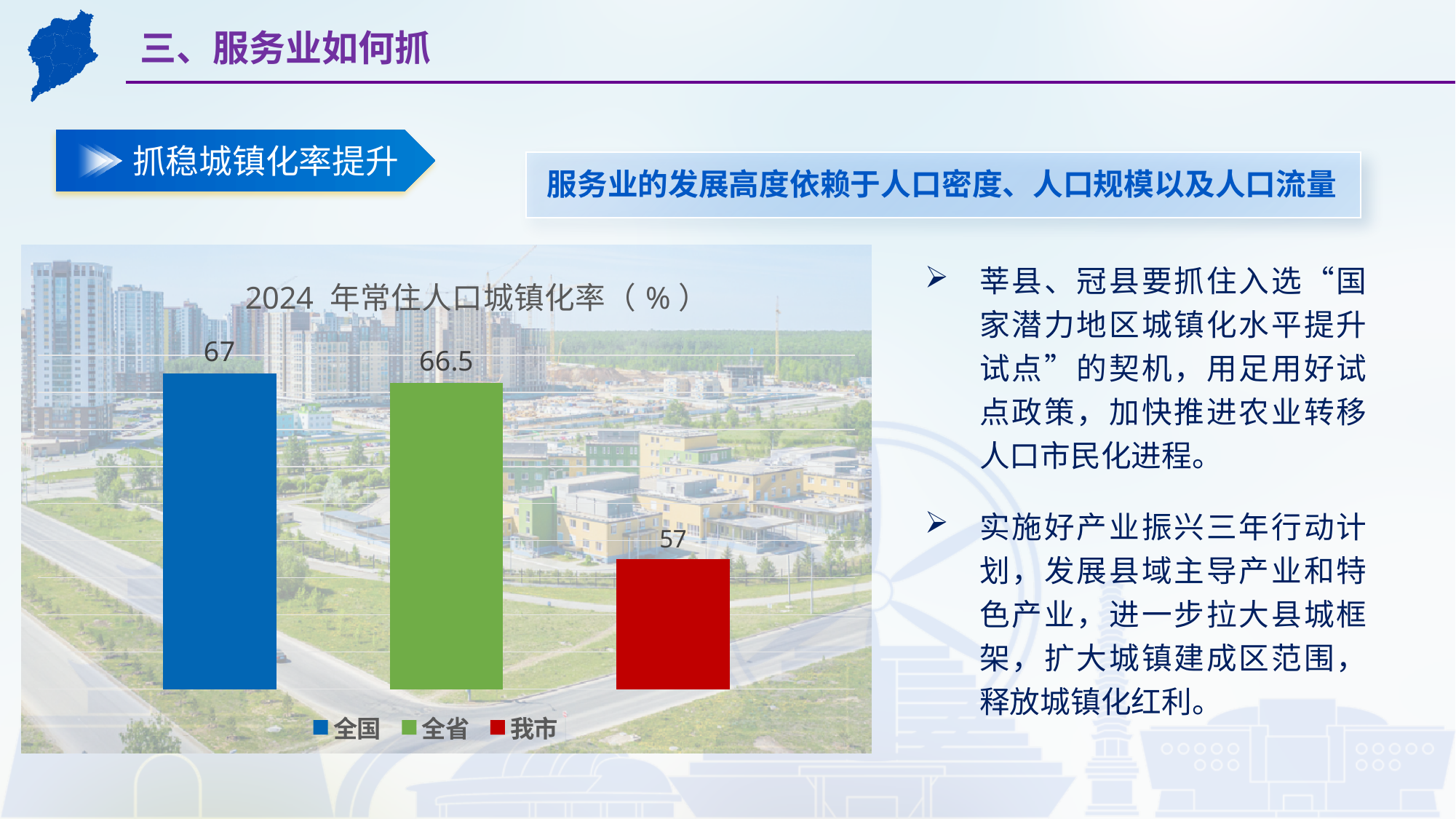
What is the difference between the values for 全省 and 我市? 9.5 What is the title of the chart? 2024 年常住人口城镇化率（%） What is the value for 全省 in the chart? 66.5 How many bars are plotted in the chart? 3 Which category has the lowest value in the chart? 我市 Which is larger, the value for 全省 or the value for 我市? 全省 What is the value for 全国 in the chart? 67 What is the value for 我市 in the chart? 57 How many entries does the legend list? 3 What kind of chart is shown on the slide? bar chart Which category has the highest value in the chart? 全国 What is the difference between the values for 全国 and 我市? 10